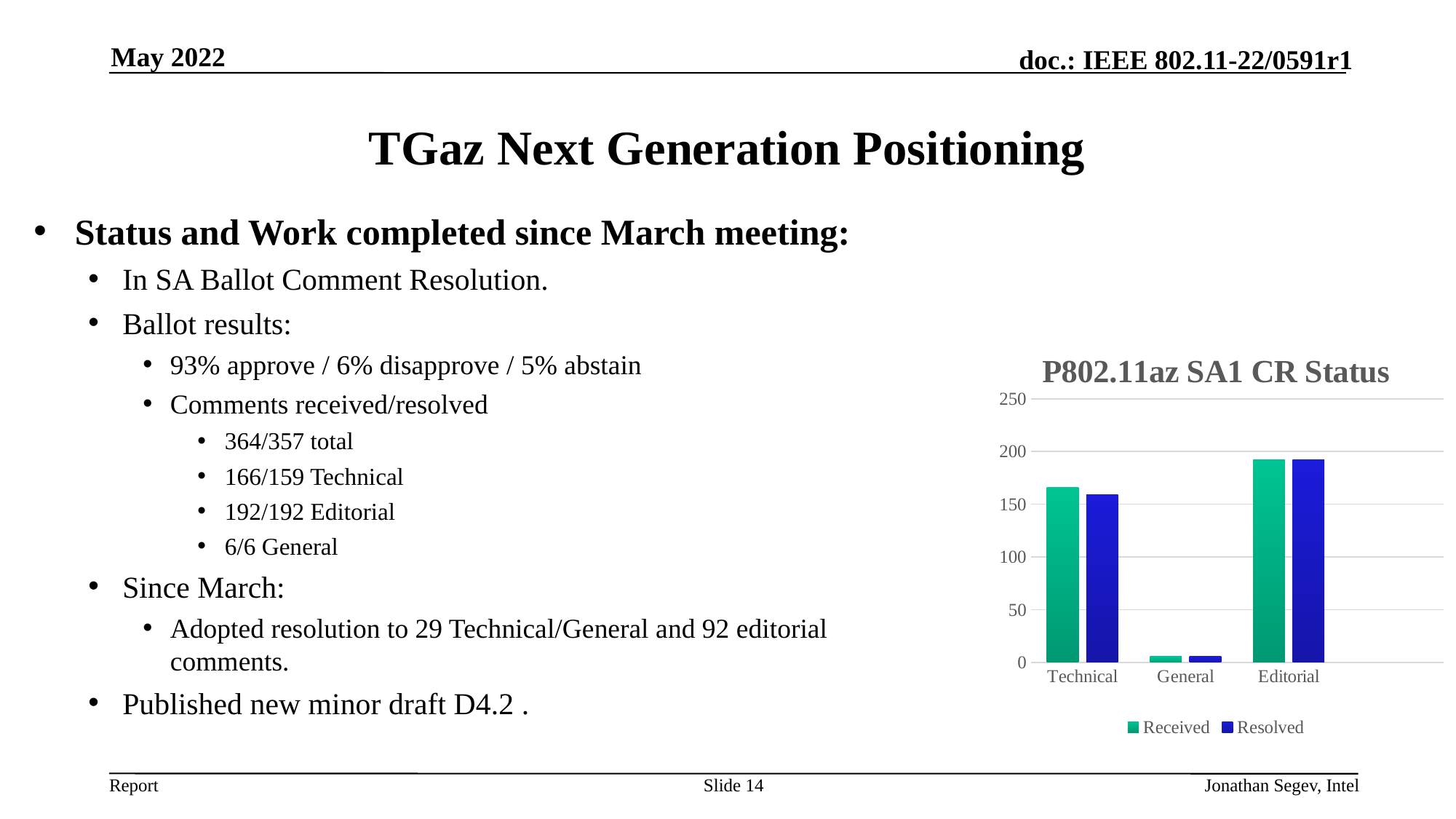
What is the title of the chart? P802.11az SA1 CR Status Is the Resolved value for General greater or less than 50? less How many series does the chart legend list? 2 Which series is shown in blue in the chart? Resolved What type of chart is shown on the slide? bar chart Is the Resolved value for Editorial greater or less than 150? greater Which is larger, the Received value for Editorial or the Received value for Technical? Editorial Is the Received value for Editorial greater or less than 200? less Which category has the highest Received value? Editorial How many categories are shown on the x axis of the chart? 3 Which category has the lowest Resolved value? General